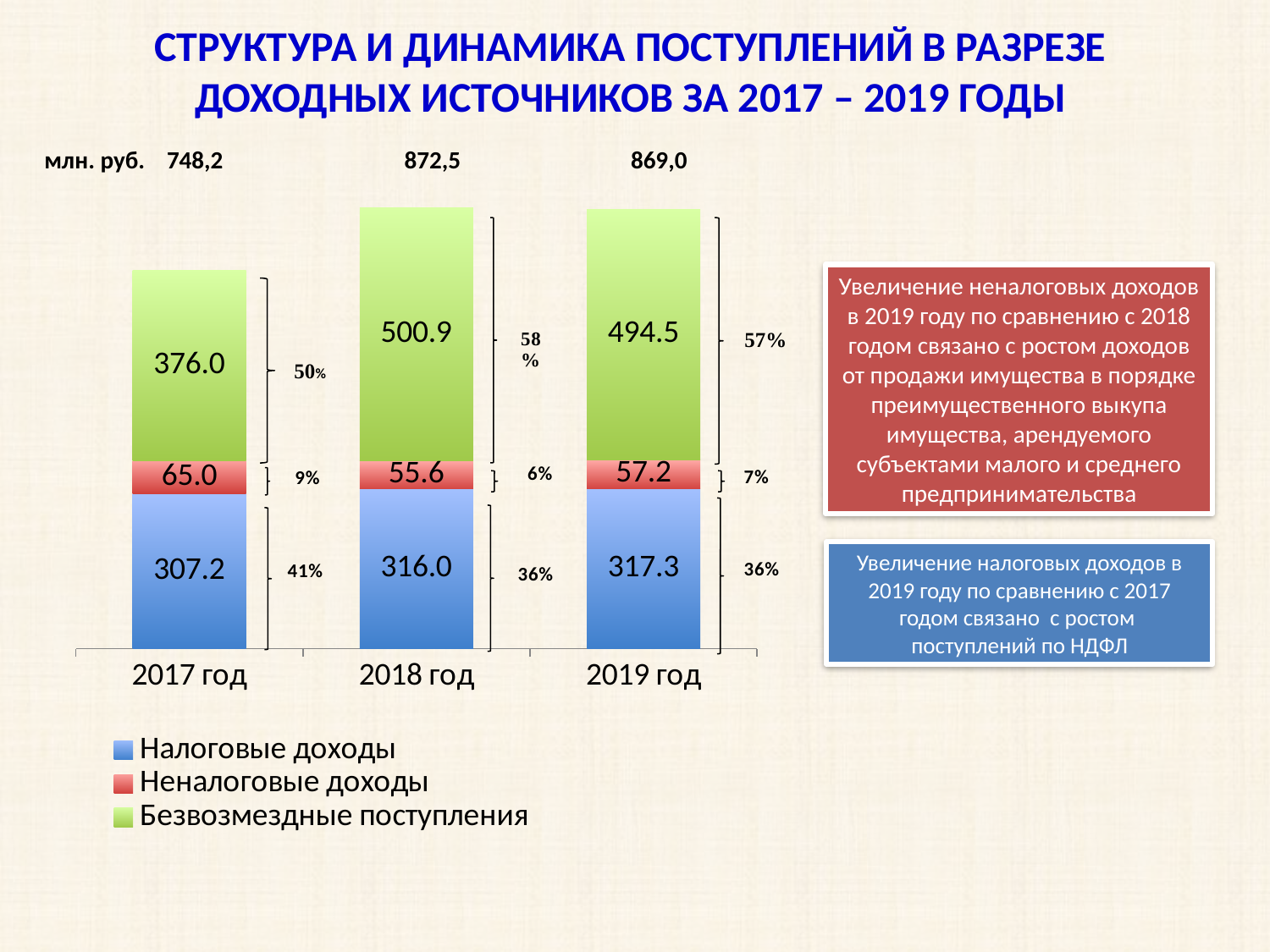
Which is larger: Неналоговые доходы in 2017 год or in 2019 год? 2017 год How many series does the legend list? 3 What type of chart is shown on the slide? stacked bar chart What is the value of Неналоговые доходы for 2019 год? 57.2 What is the difference between Налоговые доходы in 2019 год and in 2017 год? 10.1 What is the value of Безвозмездные поступления for 2018 год? 500.9 In which year is Безвозмездные поступления the highest? 2018 год What share of the 2019 год total do Безвозмездные поступления make up, according to the label on the slide? 57% How many years (categories) are shown on the x axis? 3 What is the value of Налоговые доходы for 2017 год? 307.2 What is the total of the stacked bar for 2018 год, as printed above the chart? 872,5 In which year is Неналоговые доходы the lowest? 2018 год